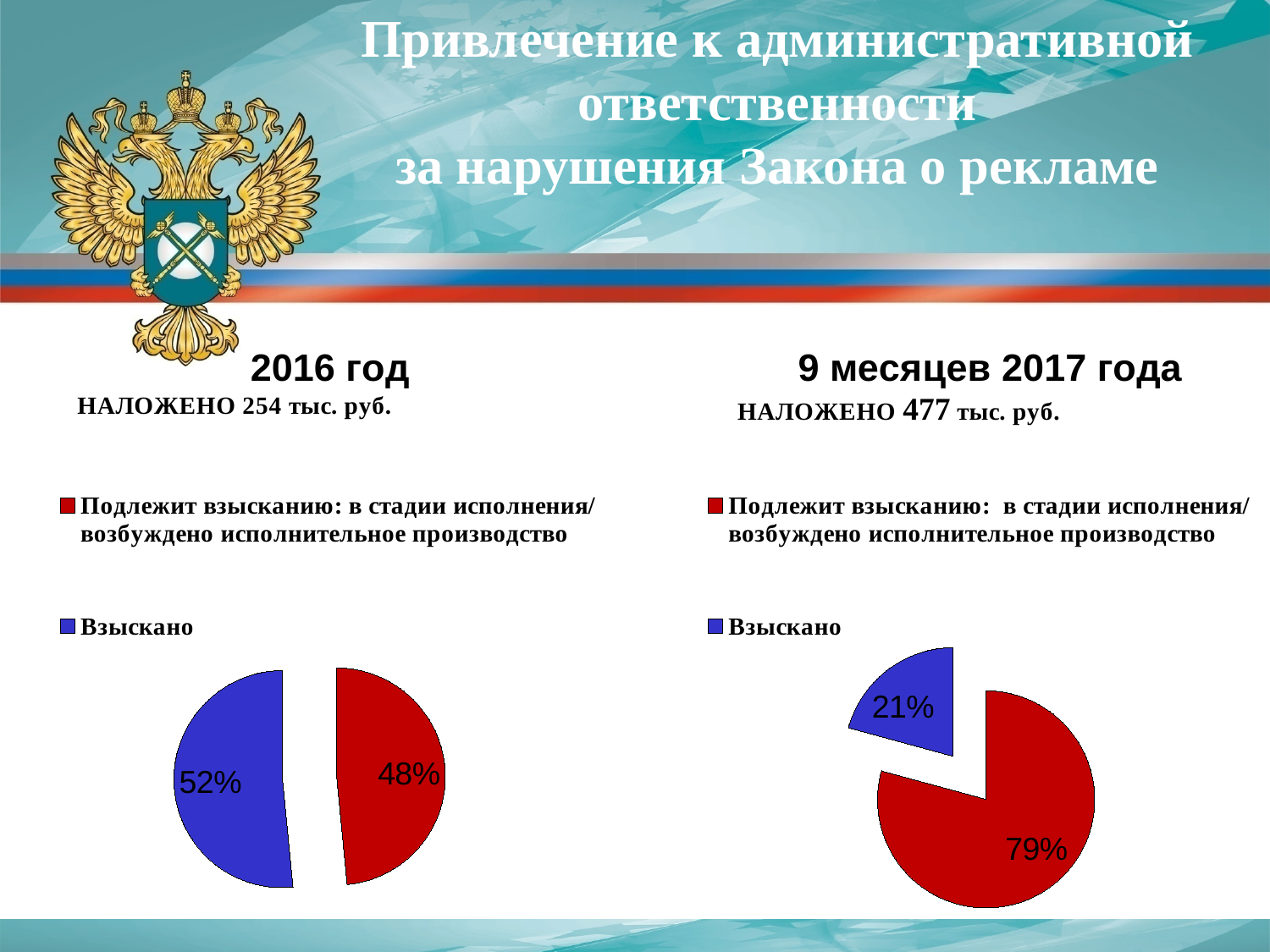
In the "2016 год" pie chart, which category has the smallest slice? Подлежит взысканию: в стадии исполнения/ возбуждено исполнительное производство How many slices does the "2016 год" pie chart have? 2 In the "9 месяцев 2017 года" pie chart, what share is labelled "Подлежит взысканию: в стадии исполнения/ возбуждено исполнительное производство"? 79% In the "2016 год" pie chart, what share is labelled "Взыскано"? 52% In the "2016 год" chart, what colour is the "Взыскано" slice? blue In the "9 месяцев 2017 года" pie chart, which category has the largest slice? Подлежит взысканию: в стадии исполнения/ возбуждено исполнительное производство In the "9 месяцев 2017 года" pie chart, what share is labelled "Взыскано"? 21% How many entries does the legend of the "9 месяцев 2017 года" chart list? 2 What kind of chart is shown under "2016 год"? pie chart In the "2016 год" pie chart, what share is labelled "Подлежит взысканию: в стадии исполнения/ возбуждено исполнительное производство"? 48% In the "9 месяцев 2017 года" pie chart, what is the difference in percentage points between the two slices? 58 Which is larger: the "Взыскано" share in the "2016 год" chart or the "Взыскано" share in the "9 месяцев 2017 года" chart? 2016 год